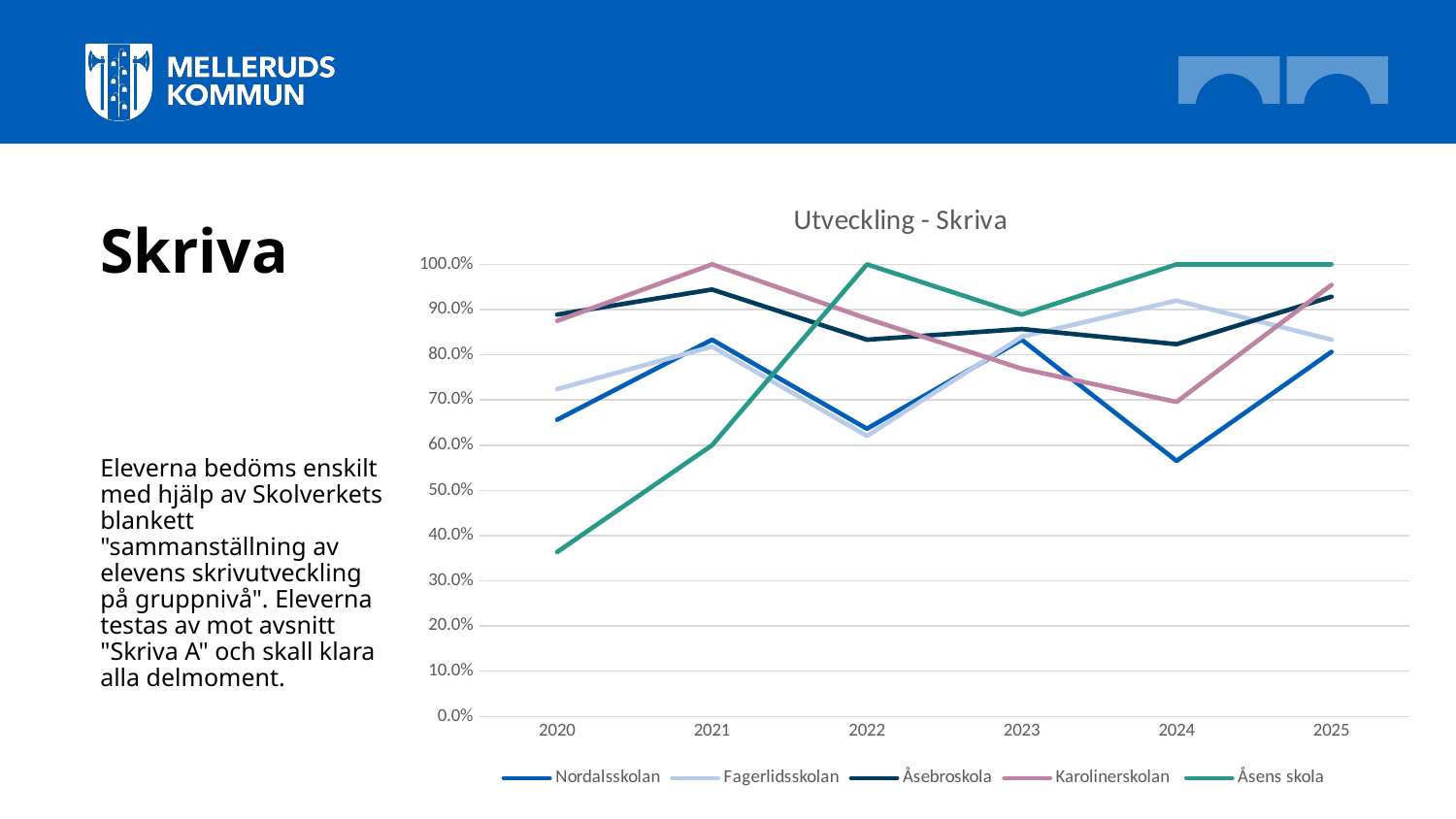
What is the value for Åsens skola in 2025? 100.0% How many years are shown on the x axis of the chart? 6 What is the value for Karolinerskolan in 2021? 100.0% What is the title of the chart? Utveckling - Skriva In 2024, which is larger: the value for Nordalsskolan or the value for Fagerlidsskolan? Fagerlidsskolan What kind of chart is shown on the slide? line chart How many series does the legend of the chart list? 5 Which series has the highest value in 2024? Åsens skola Which series has the lowest value in 2020? Åsens skola Is the value for Nordalsskolan in 2024 greater or less than 60.0%? less Is the value for Åsens skola in 2020 greater or less than 40.0%? less Does the value for Åsens skola rise or fall from 2020 to 2022? rise